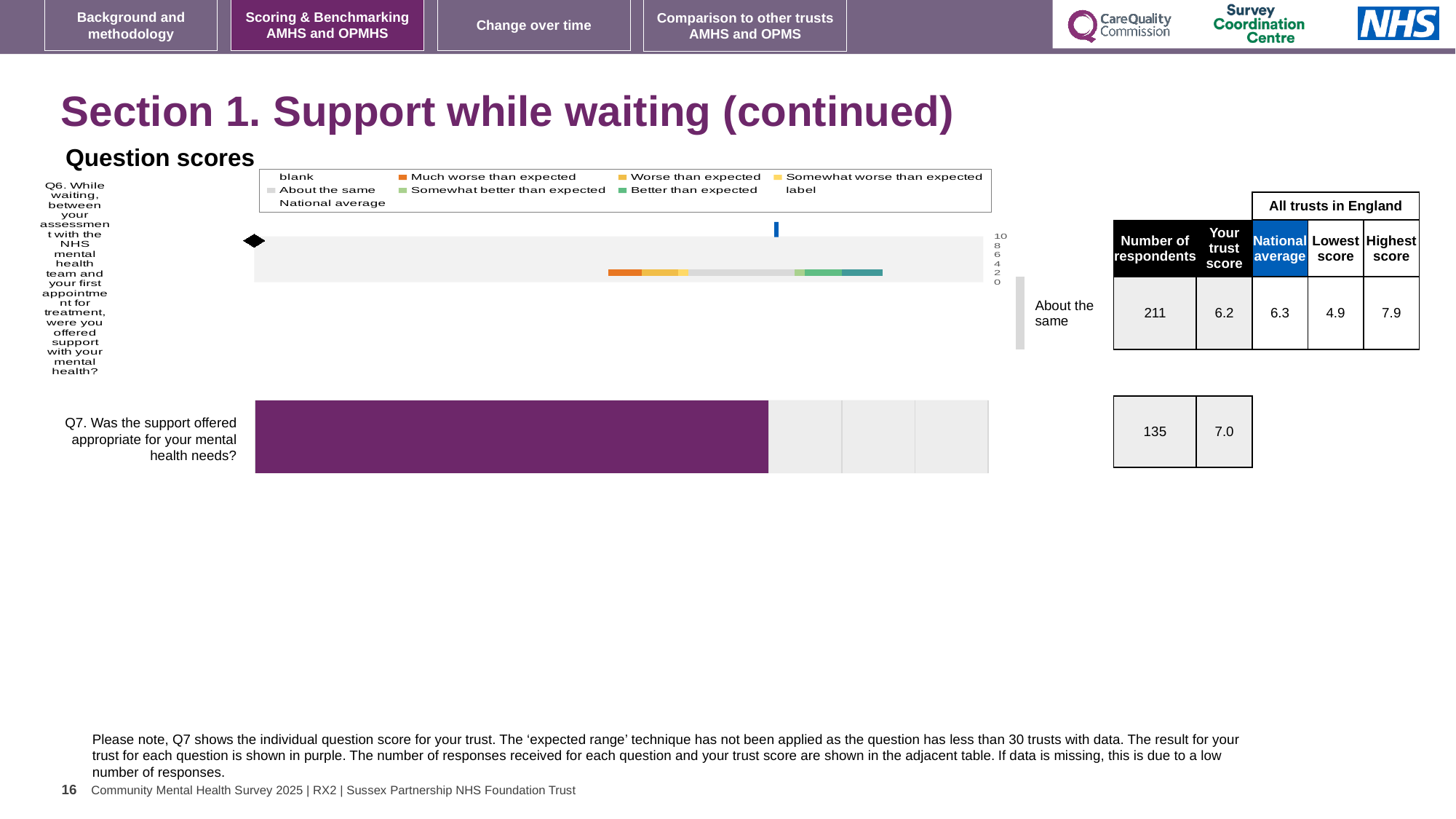
For Q6 (support while waiting), what is your trust score shown in the adjacent table? 6.2 For Q7, what is your trust score shown in the adjacent table? 7.0 For Q6, what is the national average score shown in the adjacent table? 6.3 In the Q6 chart legend, what colour represents 'Much worse than expected'? orange For Q6, what is the difference between the highest score and the lowest score among all trusts in England? 3.0 What kind of chart is used for Q7 (Was the support offered appropriate for your mental health needs?)? bar chart How many respondents answered Q6? 211 How many questions are charted on this slide? 2 For Q6, what is the lowest score among all trusts in England? 4.9 In the Q6 chart legend, what colour represents 'Better than expected'? teal For Q6, which is larger: your trust score or the national average? national average For Q6, what is the highest score among all trusts in England? 7.9